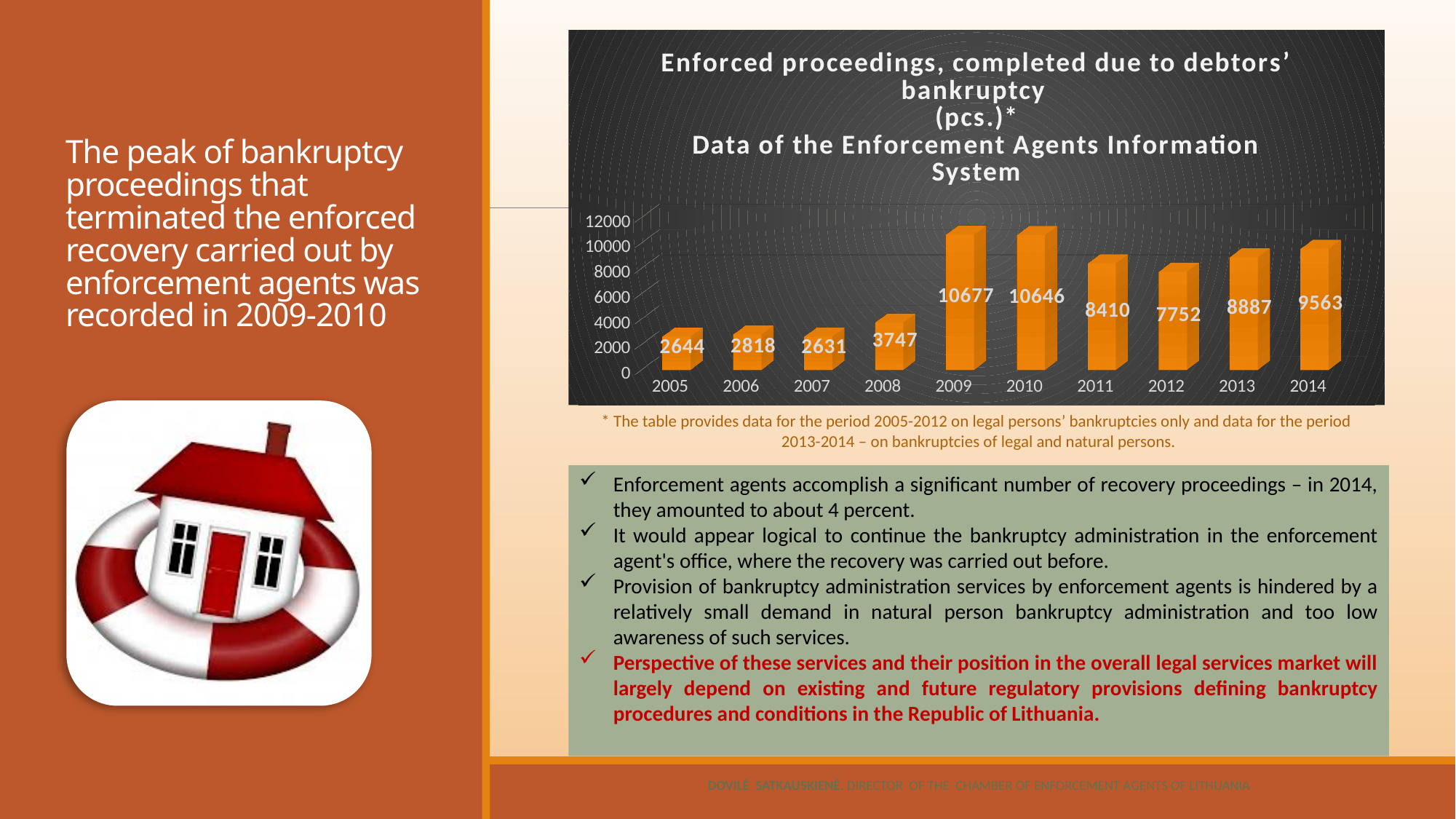
Which year has the highest value? 2009 How many years are shown on the x axis? 10 What is the difference between the values for 2009 and 2010? 31 What kind of chart is shown? bar chart Do the values rise or fall from 2012 to 2014? rise Which is larger, the value for 2011 or the value for 2012? 2011 Is the value for 2008 greater or less than 4000? less Which year has the lowest value? 2007 What is the value for 2014? 9563 What is the value for 2009? 10677 What is the difference between the values for 2014 and 2013? 676 What is the value for 2005? 2644